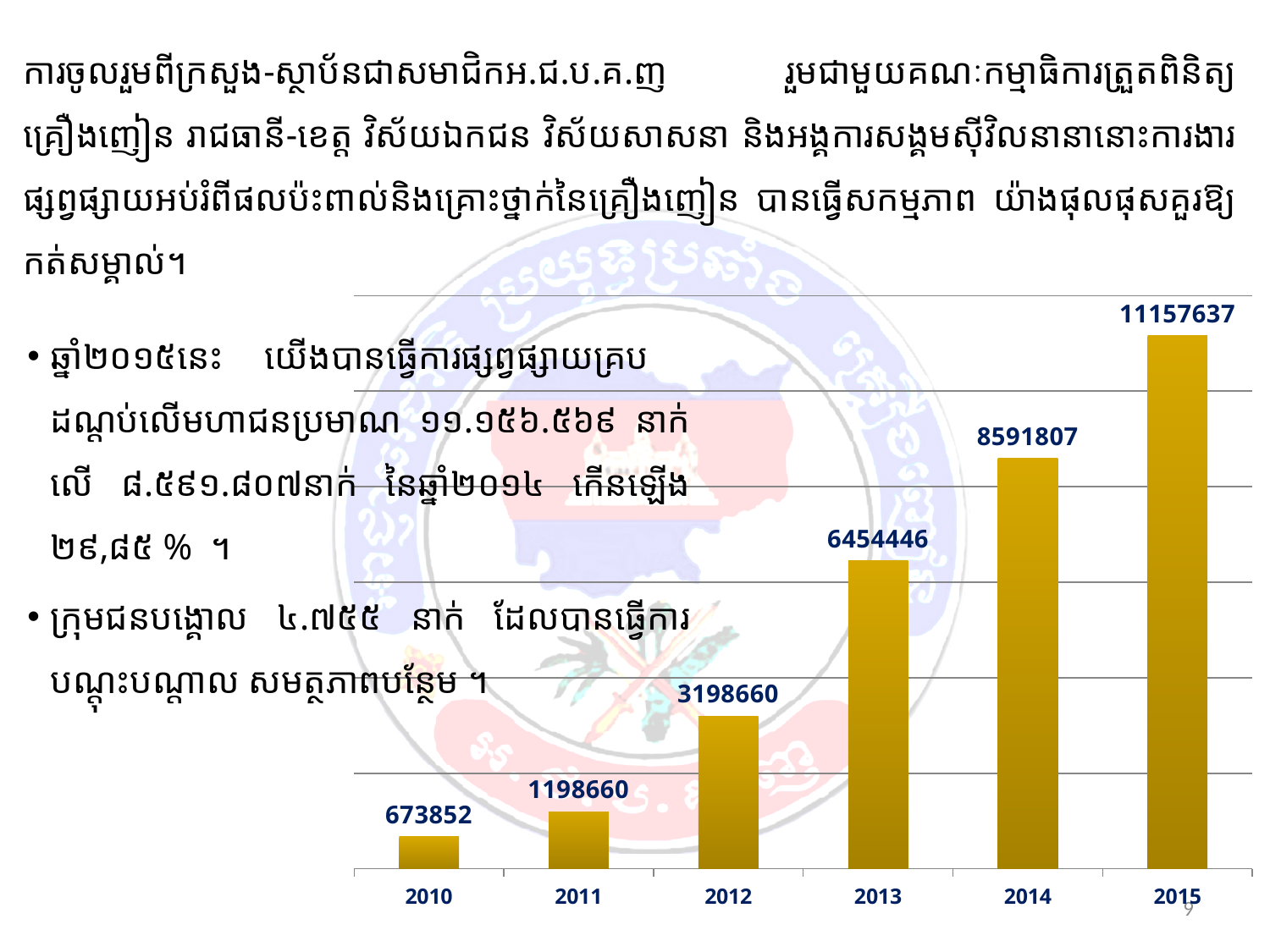
Which year has the highest value? 2015 What is the value for 2010? 673852 What is the difference between the values for 2015 and 2014? 2565830 How many years are shown on the x axis? 6 What kind of chart is this? bar chart What is the value for 2015? 11157637 What is the difference between the values for 2012 and 2011? 2000000 Which is larger, the value for 2013 or the value for 2014? 2014 Do the values rise or fall from 2010 to 2015? rise What is the value for 2011? 1198660 Which year has the lowest value? 2010 What is the value for 2013? 6454446